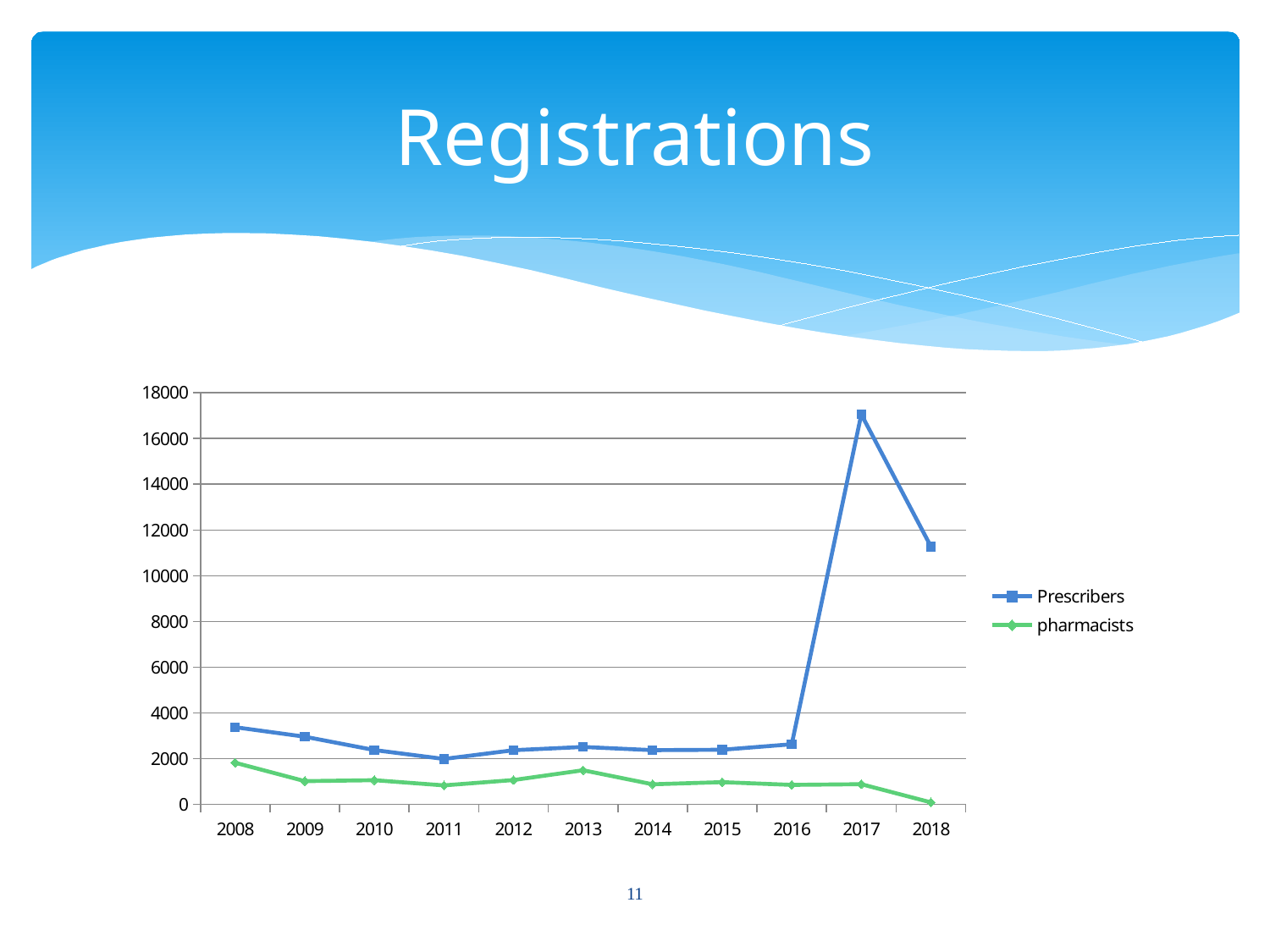
Is the Prescribers value for 2018 greater or less than 10000? greater What kind of chart is shown on the slide? Line chart What is the title of the slide containing the chart? Registrations In which year is the pharmacists value lowest? 2018 In which year is the Prescribers value lowest? 2011 Does the Prescribers value rise or fall from 2017 to 2018? Fall How many series does the legend list? 2 Is the pharmacists value for 2008 greater or less than 2000? less How many years are plotted along the x axis? 11 In which year is the Prescribers value highest? 2017 Which series has the larger value in 2017, Prescribers or pharmacists? Prescribers Is the Prescribers value for 2017 greater or less than 16000? greater